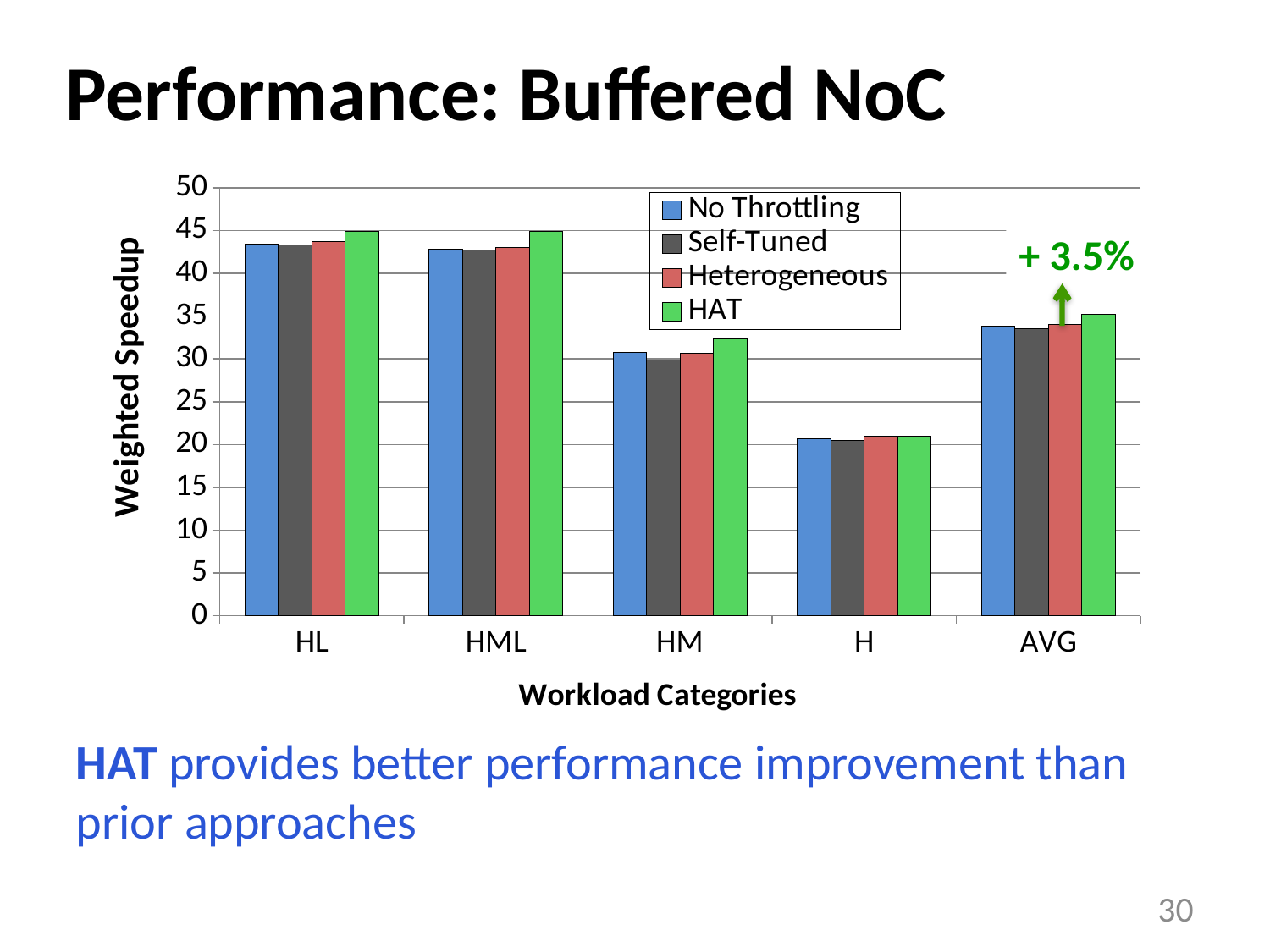
How many workload categories are shown on the x axis? 5 Which is larger: the No Throttling value for HL or the No Throttling value for H? HL Is the Self-Tuned value for HML greater or less than 40? greater How many series does the legend list? 4 What improvement percentage is annotated above the AVG group? + 3.5% What kind of chart is shown on the slide? bar chart What is the label of the y axis? Weighted Speedup Which workload category has the lowest weighted speedup across all series? H Is the No Throttling value for H greater or less than 25? less Is the HAT value for HL greater or less than 40? greater For the HM category, which is larger: the HAT value or the Self-Tuned value? HAT